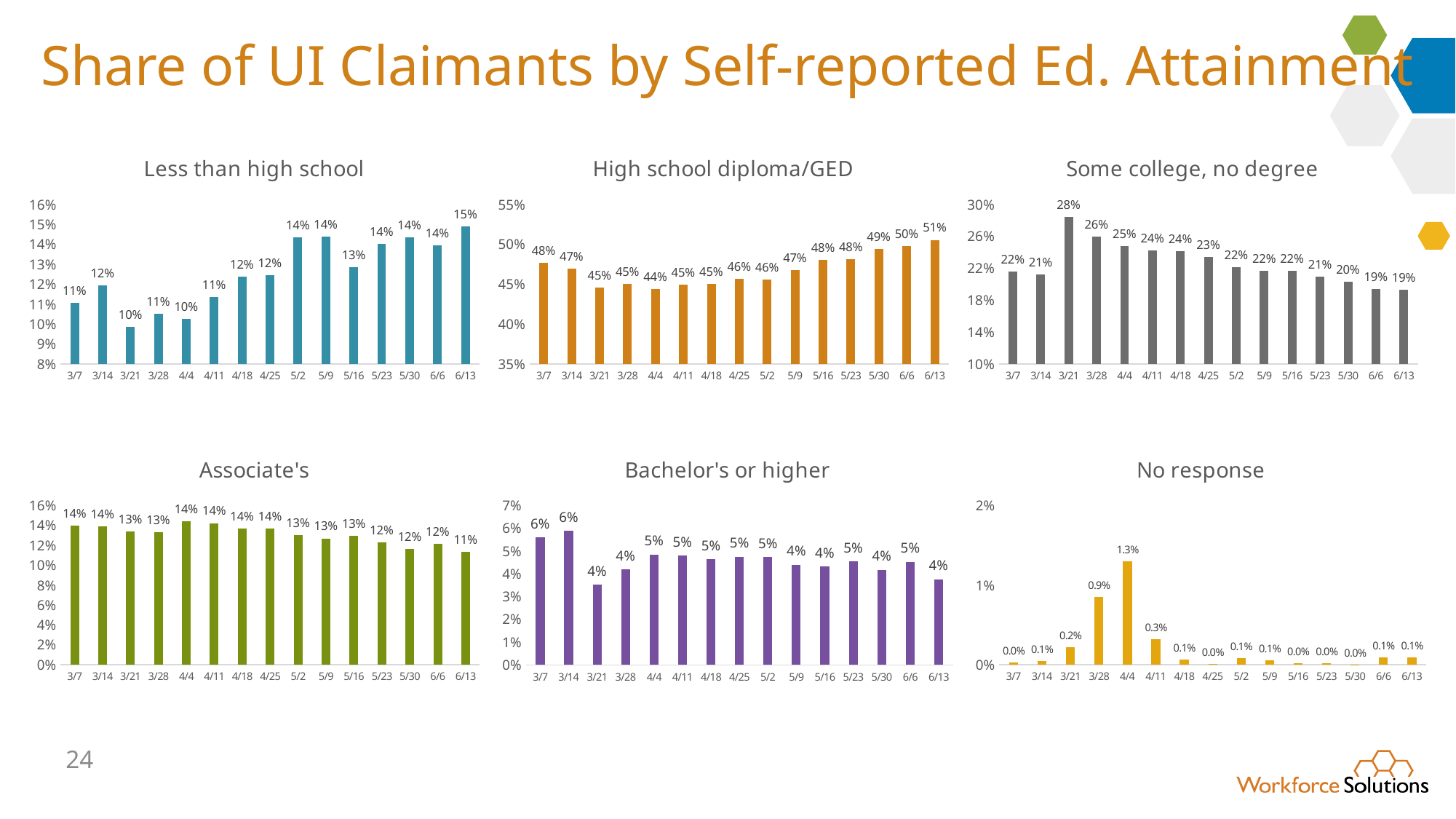
In the 'Bachelor's or higher' chart, what is the value for 3/7? 6% In the 'High school diploma/GED' chart, what is the value for 6/13? 51% In the 'High school diploma/GED' chart, which date has the lowest value? 4/4 In the 'Less than high school' chart, what is the value for 6/13? 15% What type of chart is the 'Associate's' chart? bar chart In the 'Associate's' chart, which date has the lowest value? 6/13 In the 'High school diploma/GED' chart, is the value for 3/7 larger or smaller than the value for 4/4? larger How many dates are shown on the x axis of the 'Less than high school' chart? 15 In the 'No response' chart, which date has the highest value? 4/4 In the 'Some college, no degree' chart, what is the difference between the values for 3/21 and 6/13? 9% In the 'Some college, no degree' chart, which date has the highest value? 3/21 In the 'No response' chart, what is the value for 3/28? 0.9%